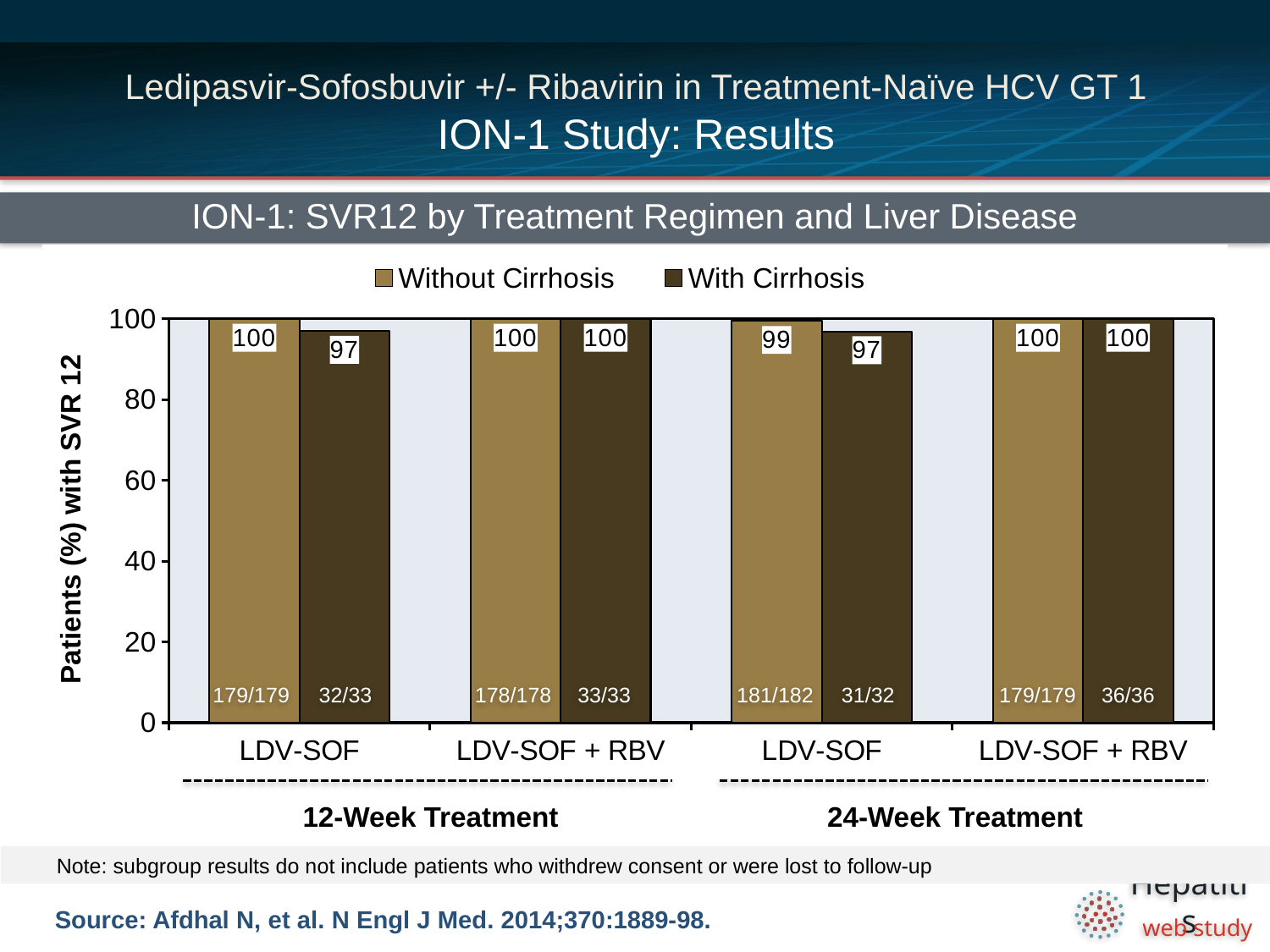
What is the SVR12 rate for patients with cirrhosis receiving LDV-SOF for 12 weeks? 97 How many series does the legend list? 2 What fraction of patients is shown for the With Cirrhosis bar in the 24-week LDV-SOF group? 31/32 What fraction of patients is shown for the Without Cirrhosis bar in the 12-week LDV-SOF + RBV group? 178/178 What is the label of the y-axis? Patients (%) with SVR 12 What is the SVR12 rate for patients with cirrhosis receiving LDV-SOF + RBV for 24 weeks? 100 What is the SVR12 rate for patients without cirrhosis receiving LDV-SOF for 12 weeks? 100 What is the SVR12 rate for patients without cirrhosis receiving LDV-SOF for 24 weeks? 99 What is the difference between the Without Cirrhosis and With Cirrhosis SVR12 rates in the 12-week LDV-SOF group? 3 What type of chart is shown on the slide? Bar chart In the 24-week LDV-SOF group, which is larger: the SVR12 rate for patients without cirrhosis or with cirrhosis? Without cirrhosis Which treatment group has the lowest SVR12 rate for patients without cirrhosis? LDV-SOF, 24-Week Treatment